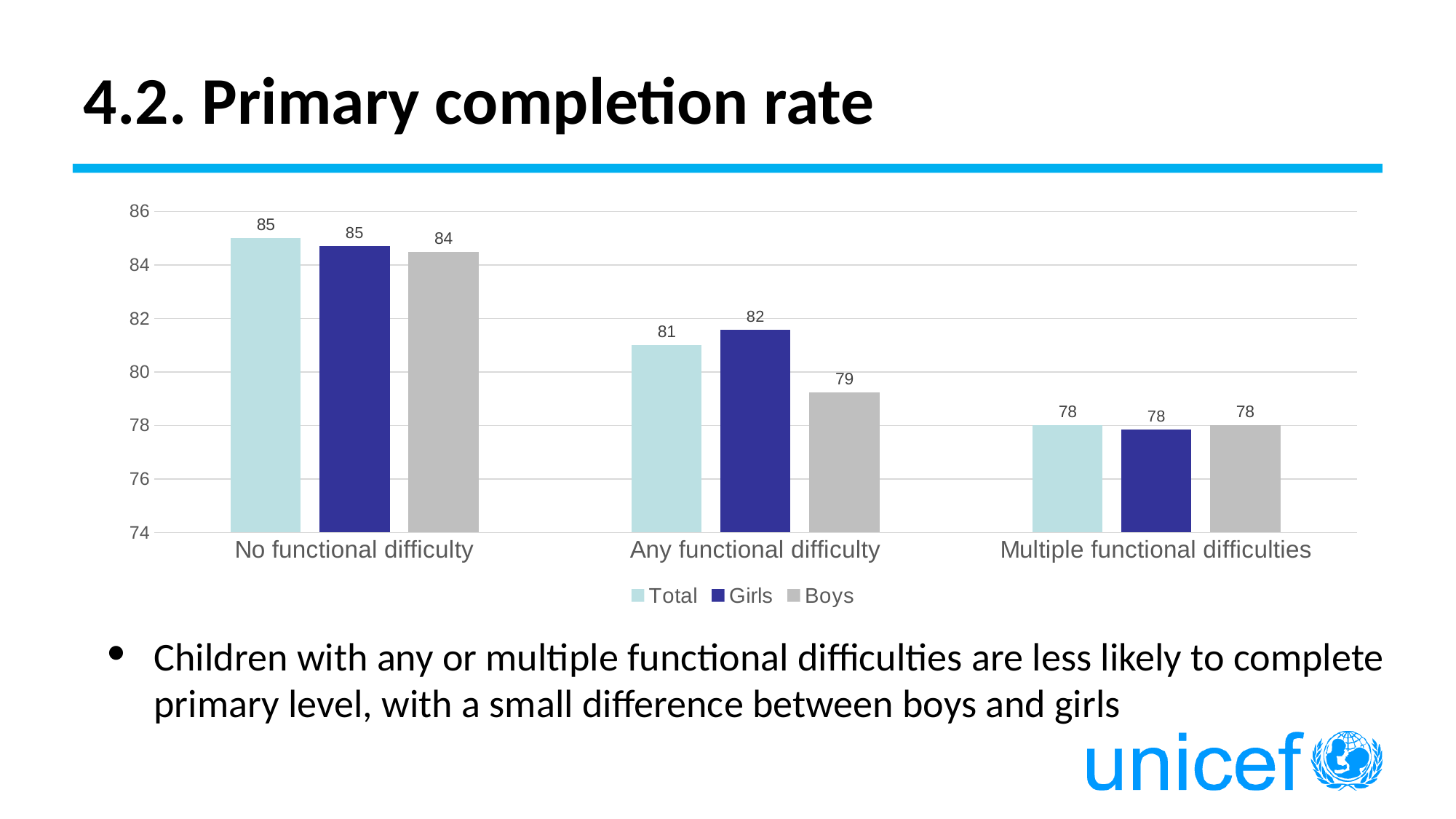
How many categories are shown on the x axis? 3 What is the Girls value for the 'Any functional difficulty' category? 82 What is the Boys value for the 'Any functional difficulty' category? 79 For 'Any functional difficulty', is the Girls value or the Boys value larger? Girls What is the Total value for 'Multiple functional difficulties'? 78 Which category has the lowest Total primary completion rate? Multiple functional difficulties What is the Total primary completion rate for children with no functional difficulty? 85 Which category has the highest Boys value? No functional difficulty Do the Total values rise or fall moving from 'No functional difficulty' to 'Multiple functional difficulties'? Fall How many series does the legend list? 3 What is the difference between the Girls and Boys values for 'Any functional difficulty'? 3 What type of chart is shown on the slide? Bar chart